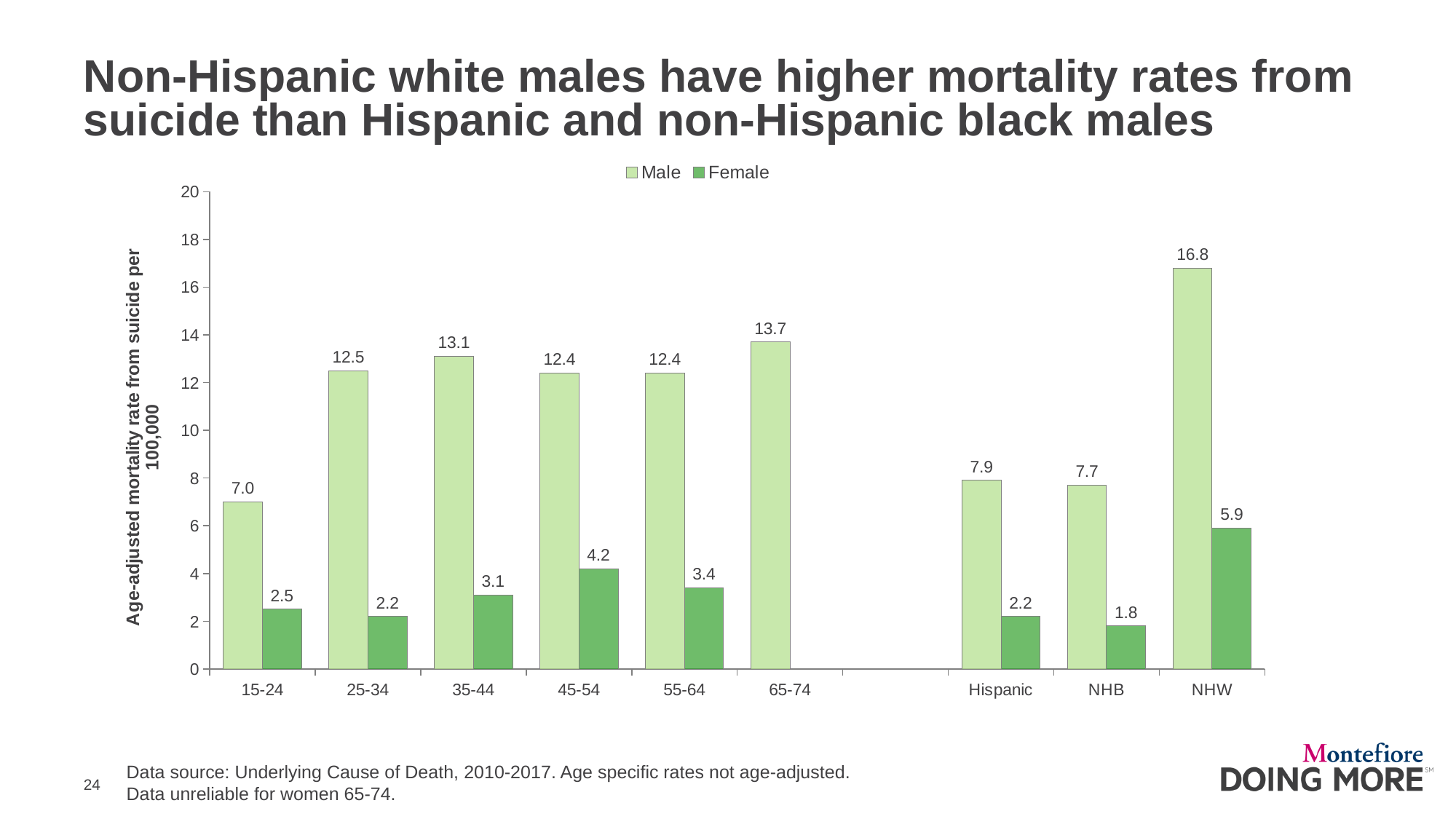
What is the y-axis label of the chart? Age-adjusted mortality rate from suicide per 100,000 Is the Male value for NHW greater or less than 16? greater What is the Male value for the 35-44 age group? 13.1 How many categories are shown on the x axis? 9 What is the difference between the Male and Female values for 45-54? 8.2 What is the Female value for NHW? 5.9 How many series does the legend list? 2 Which is larger, the Male value for 25-34 or the Male value for 65-74? 65-74 What kind of chart is shown on the slide? bar chart Which category has the highest Male value? NHW Which category has the lowest Female value? NHB What is the Male value for Hispanic? 7.9